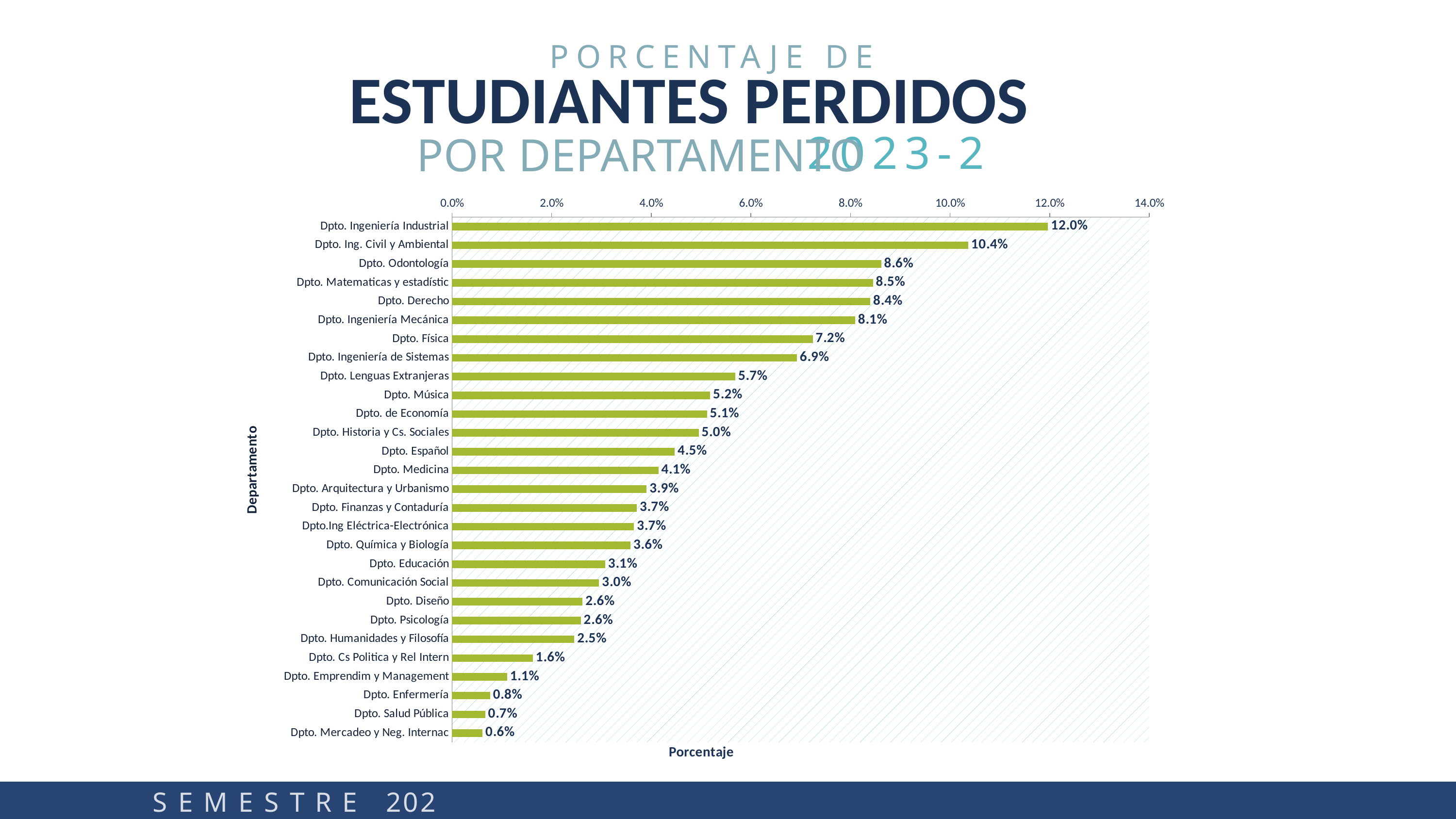
Is the value for Dpto. Odontología greater or less than 8.0%? greater What is the value for Dpto. Física? 7.2% What is the value for Dpto. Ingeniería Industrial? 12.0% What is the label of the horizontal axis? Porcentaje What is the value for Dpto. Enfermería? 0.8% Which department has the lowest percentage? Dpto. Mercadeo y Neg. Internac What kind of chart is shown on the slide? bar chart What is the value for Dpto. Medicina? 4.1% Which department has the highest percentage? Dpto. Ingeniería Industrial Which is larger, the value for Dpto. Derecho or the value for Dpto. Ingeniería de Sistemas? Dpto. Derecho What is the difference between Dpto. Ingeniería Industrial and Dpto. Ing. Civil y Ambiental? 1.6% How many departments are shown in the chart? 28